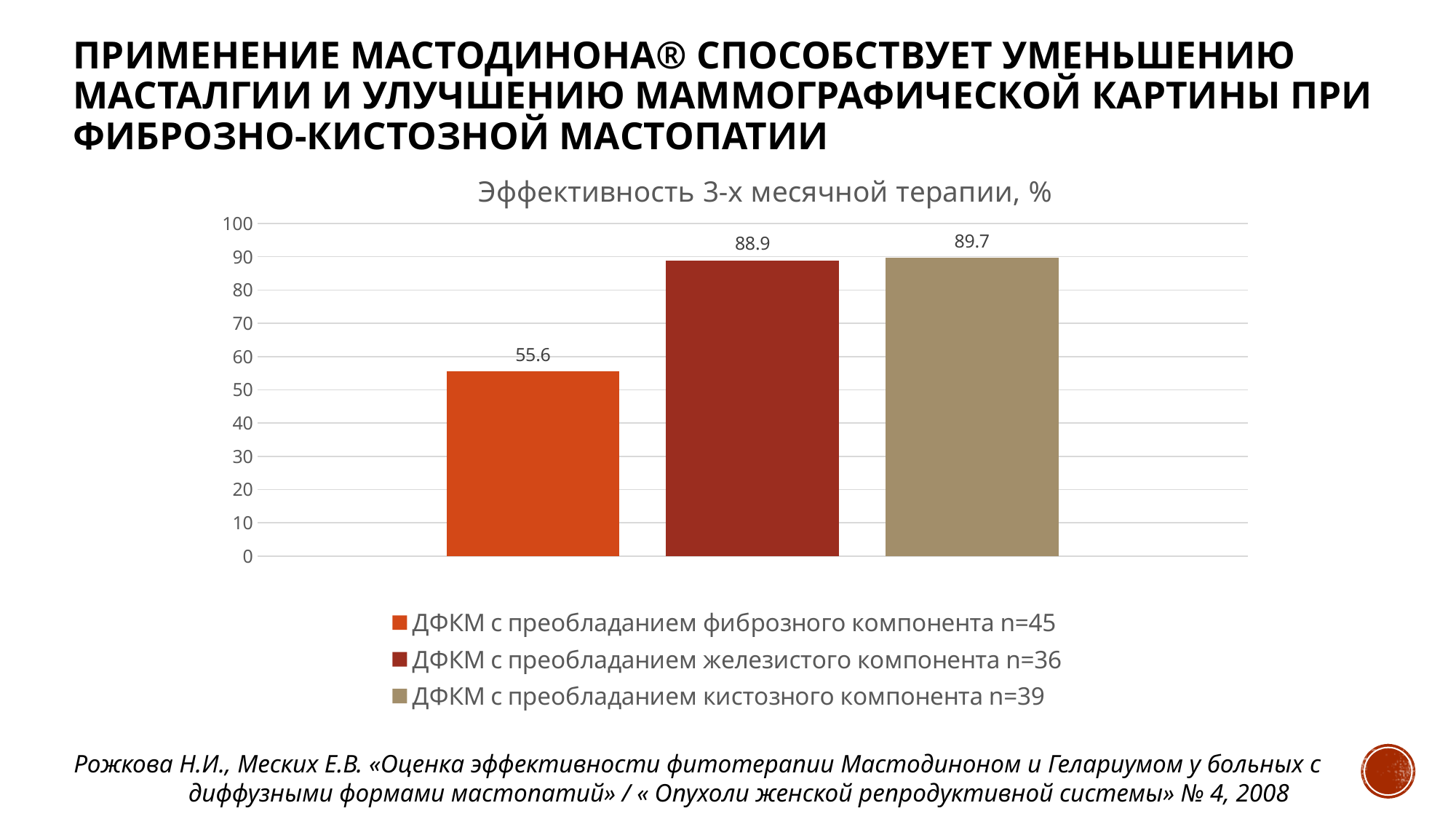
Which group has the lowest value? ДФКМ с преобладанием фиброзного компонента n=45 What is the difference between the values for ДФКМ с преобладанием кистозного компонента n=39 and ДФКМ с преобладанием фиброзного компонента n=45? 34.1 Which is larger: the value for ДФКМ с преобладанием фиброзного компонента n=45 or the value for ДФКМ с преобладанием железистого компонента n=36? ДФКМ с преобладанием железистого компонента n=36 What is the value for ДФКМ с преобладанием железистого компонента n=36? 88.9 How many entries does the legend list? 3 Which group has the highest value? ДФКМ с преобладанием кистозного компонента n=39 What is the chart's title? Эффективность 3-х месячной терапии, % How many bars are plotted in the chart? 3 What type of chart is shown on the slide? bar chart What is the value for ДФКМ с преобладанием кистозного компонента n=39? 89.7 What is the difference between the values for ДФКМ с преобладанием железистого компонента n=36 and ДФКМ с преобладанием фиброзного компонента n=45? 33.3 What is the value for ДФКМ с преобладанием фиброзного компонента n=45? 55.6